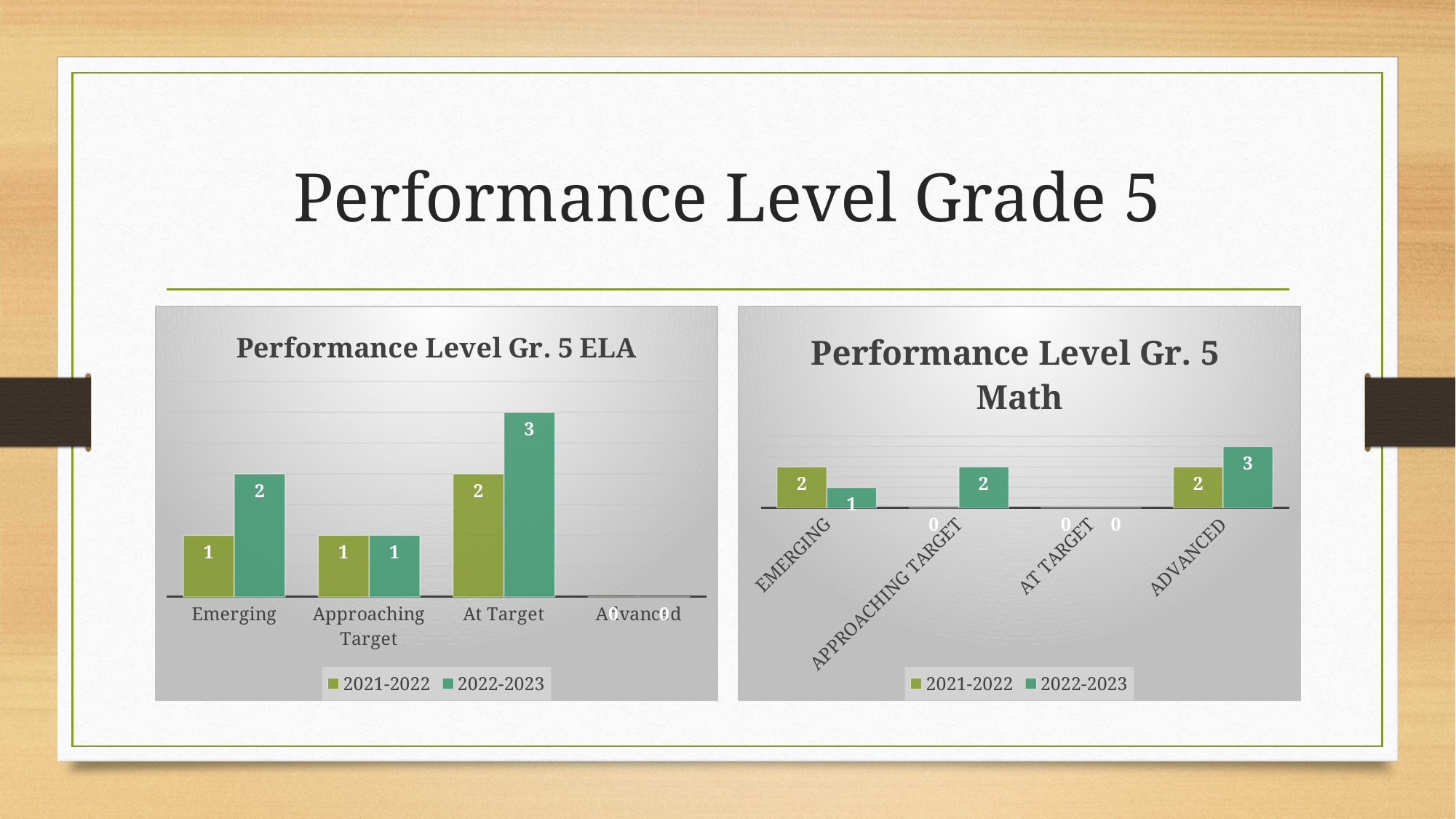
In the Performance Level Gr. 5 ELA chart, how many categories are shown on the x axis? 4 What type of chart is the Performance Level Gr. 5 ELA chart? Bar chart In the Performance Level Gr. 5 Math chart, what is the value for Advanced in 2022-2023? 3 How many series does the legend of the Performance Level Gr. 5 Math chart list? 2 In the Performance Level Gr. 5 Math chart, which is larger for Emerging: the 2021-2022 value or the 2022-2023 value? 2021-2022 In the Performance Level Gr. 5 ELA chart, what is the difference between the 2022-2023 and 2021-2022 values for At Target? 1 In the Performance Level Gr. 5 Math chart, what is the difference between the 2021-2022 and 2022-2023 values for Emerging? 1 In the Performance Level Gr. 5 Math chart, what is the value for Approaching Target in 2021-2022? 0 In the Performance Level Gr. 5 ELA chart, which category has the highest value for 2022-2023? At Target In the Performance Level Gr. 5 ELA chart, what is the value for Emerging in 2021-2022? 1 In the Performance Level Gr. 5 ELA chart, what is the value for At Target in 2022-2023? 3 In the Performance Level Gr. 5 Math chart, which category has the lowest values for both years? At Target